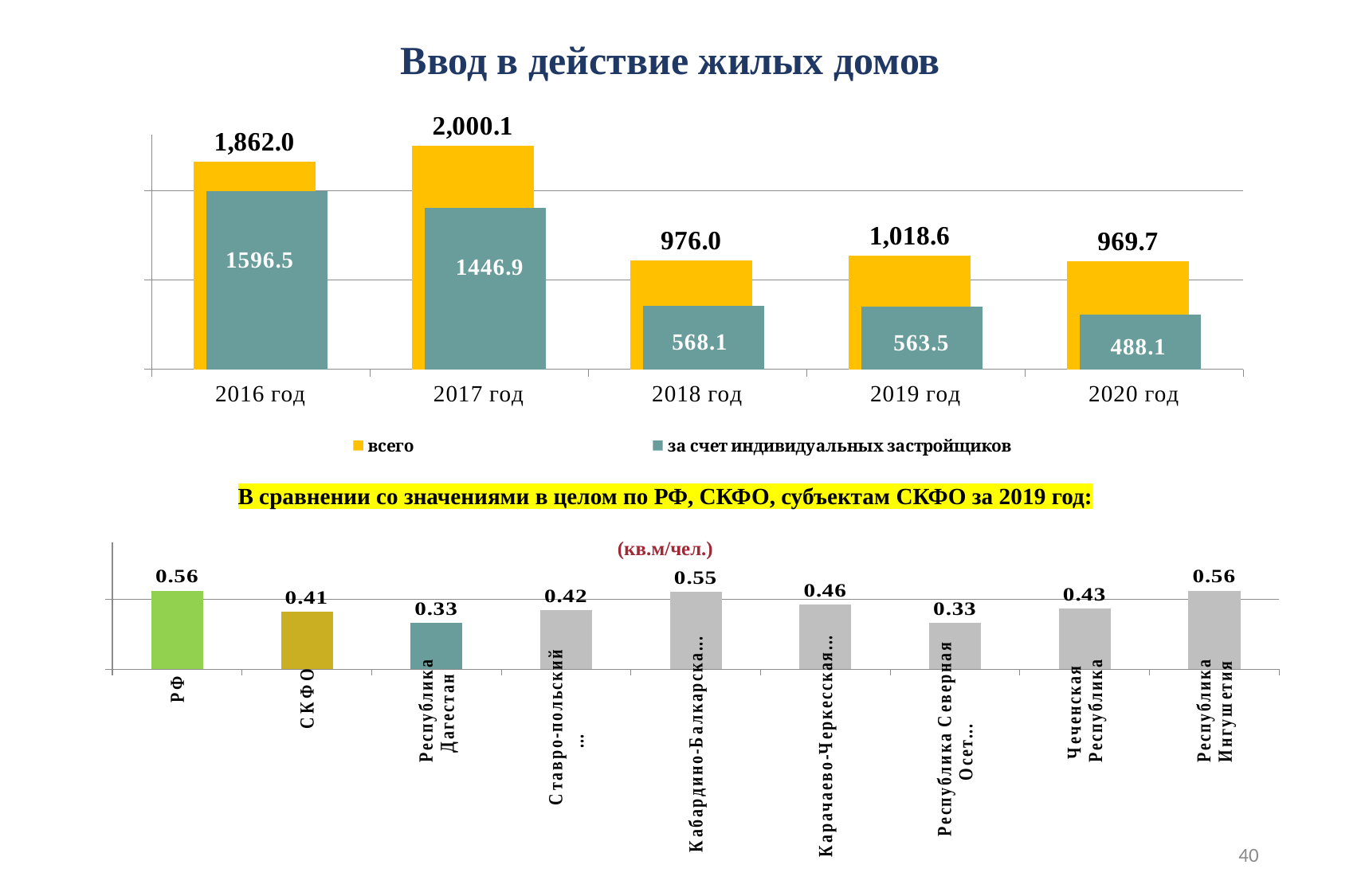
In the top chart 'Ввод в действие жилых домов', what is the difference between 'всего' and 'за счет индивидуальных застройщиков' for 2016 год? 265.5 In the top chart 'Ввод в действие жилых домов', which year has the highest 'всего' value? 2017 год In the top chart 'Ввод в действие жилых домов', which year has the lowest value for 'за счет индивидуальных застройщиков'? 2020 год In the bottom chart (кв.м/чел.), what is the difference between the values for РФ and СКФО? 0.15 In the bottom chart (кв.м/чел.), what is the value for СКФО? 0.41 In the top chart 'Ввод в действие жилых домов', how many series does the legend list? 2 In the top chart 'Ввод в действие жилых домов', what is the value of 'всего' for 2017 год? 2,000.1 In the top chart 'Ввод в действие жилых домов', does the 'всего' value rise or fall from 2017 год to 2018 год? fall In the top chart 'Ввод в действие жилых домов', what is the value of 'за счет индивидуальных застройщиков' for 2020 год? 488.1 In the top chart 'Ввод в действие жилых домов', which year has the larger 'всего' value, 2018 год or 2019 год? 2019 год In the bottom chart (кв.м/чел.), what is the value for Кабардино-Балкарская? 0.55 What kind of chart is the bottom chart comparing values for РФ, СКФО and the subjects of СКФО? bar chart